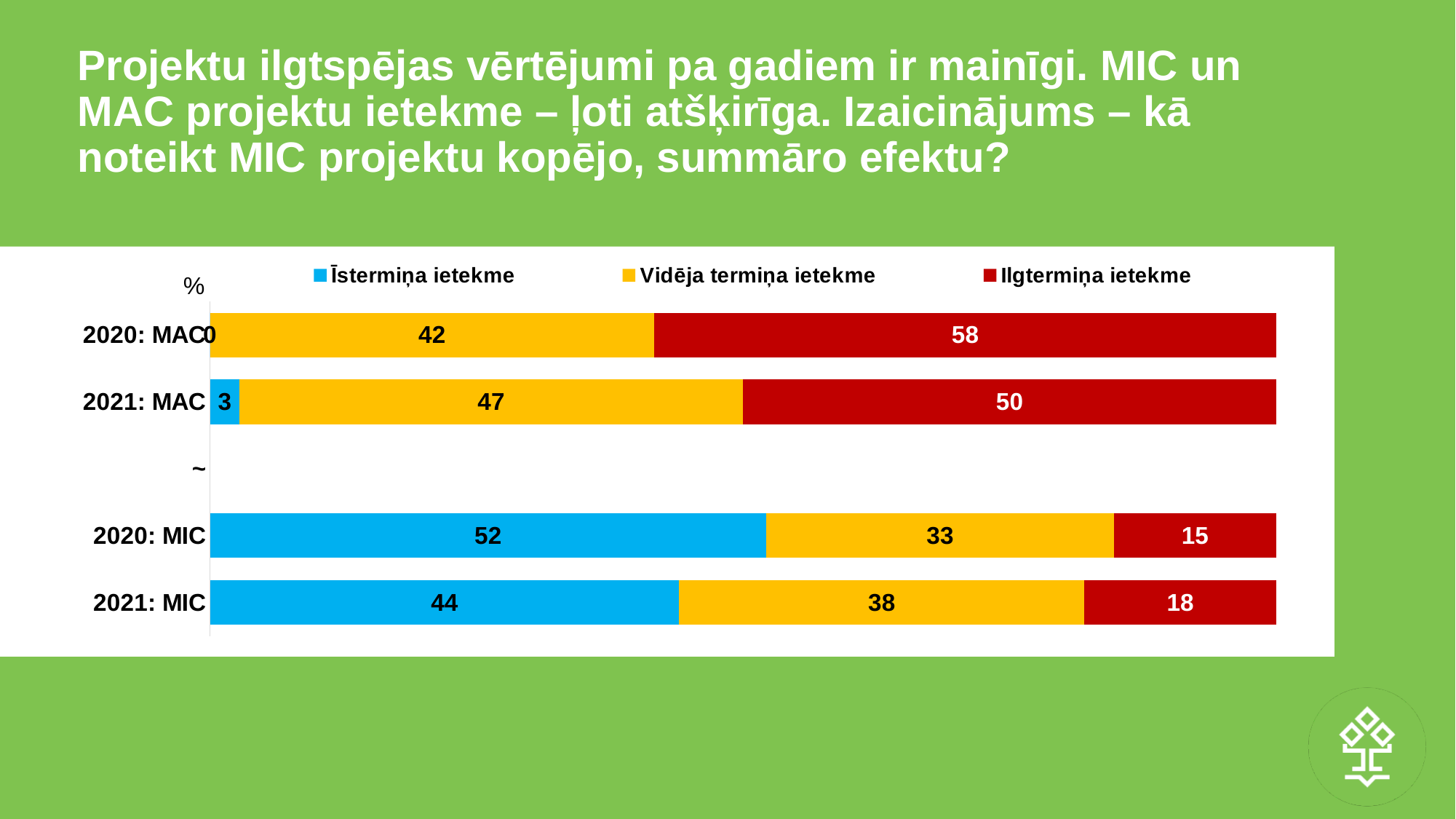
What is the difference between the Īstermiņa ietekme values for 2020: MIC and 2021: MIC? 8 Which category has the lowest value for Īstermiņa ietekme? 2020: MAC Which category has the highest value for Ilgtermiņa ietekme? 2020: MAC What is the total of the stacked bar for 2021: MIC? 100 What is the value of Īstermiņa ietekme for 2021: MIC? 44 What kind of chart is shown on the slide? Stacked bar chart Which colour represents Vidēja termiņa ietekme in the chart? Yellow What is the value of Īstermiņa ietekme for 2021: MAC? 3 Which is larger: Vidēja termiņa ietekme for 2021: MAC or for 2021: MIC? 2021: MAC How many series does the legend list? 3 What is the value of Ilgtermiņa ietekme for 2020: MAC? 58 What is the value of Vidēja termiņa ietekme for 2020: MIC? 33